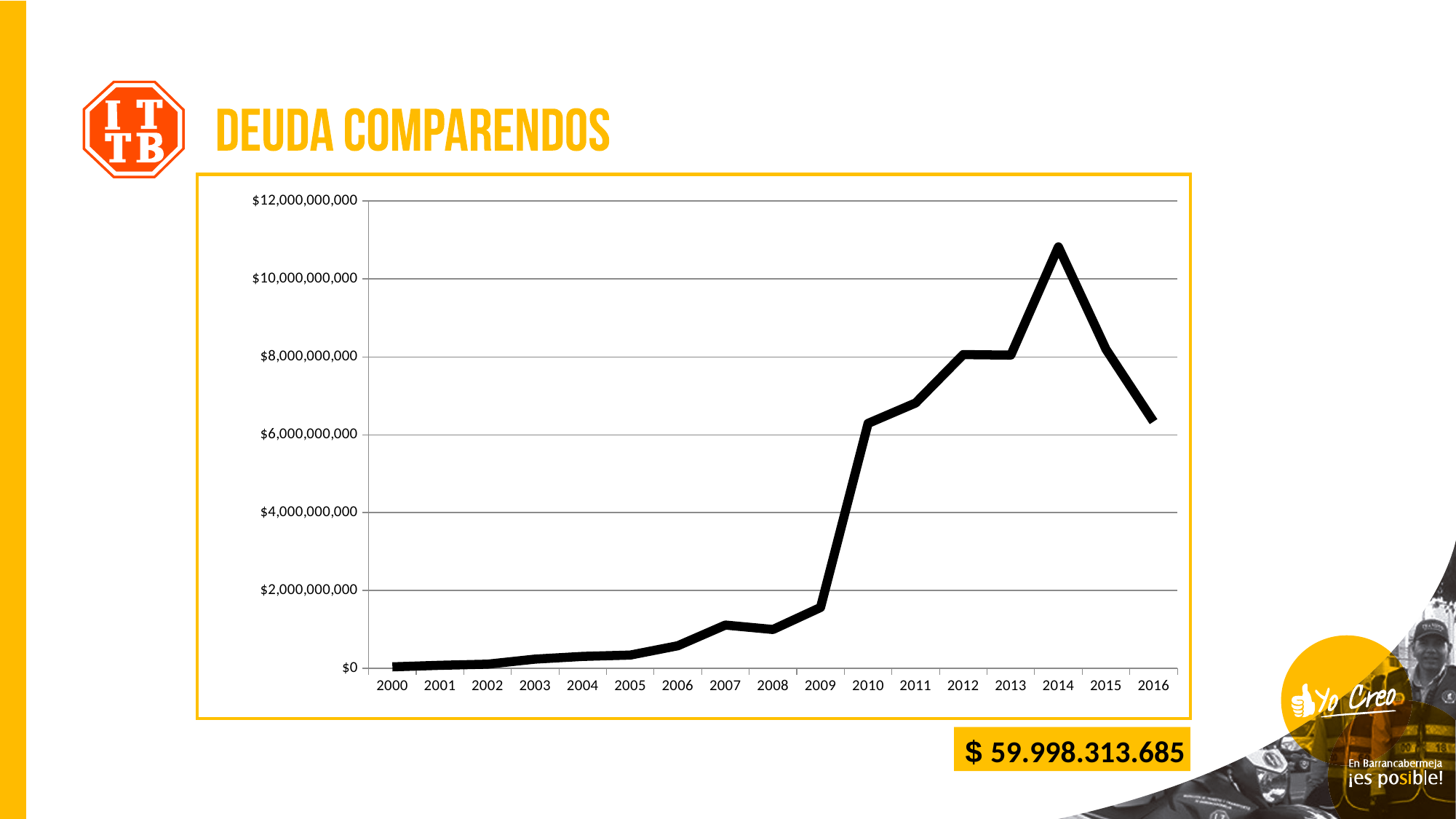
Which is larger, the value for 2014 or the value for 2016? 2014 Do the values rise or fall from 2014 to 2016? fall Is the value for 2011 greater or less than $8,000,000,000? less Which is larger, the value for 2009 or the value for 2010? 2010 Is the value for 2009 greater or less than $2,000,000,000? less What figure is printed in the yellow box below the chart? $ 59.998.313.685 Which year has the highest value? 2014 What kind of chart is shown on the slide? line chart What is the title of the chart? DEUDA COMPARENDOS How many years are plotted along the x axis? 17 Is the value for 2013 greater or less than $10,000,000,000? less